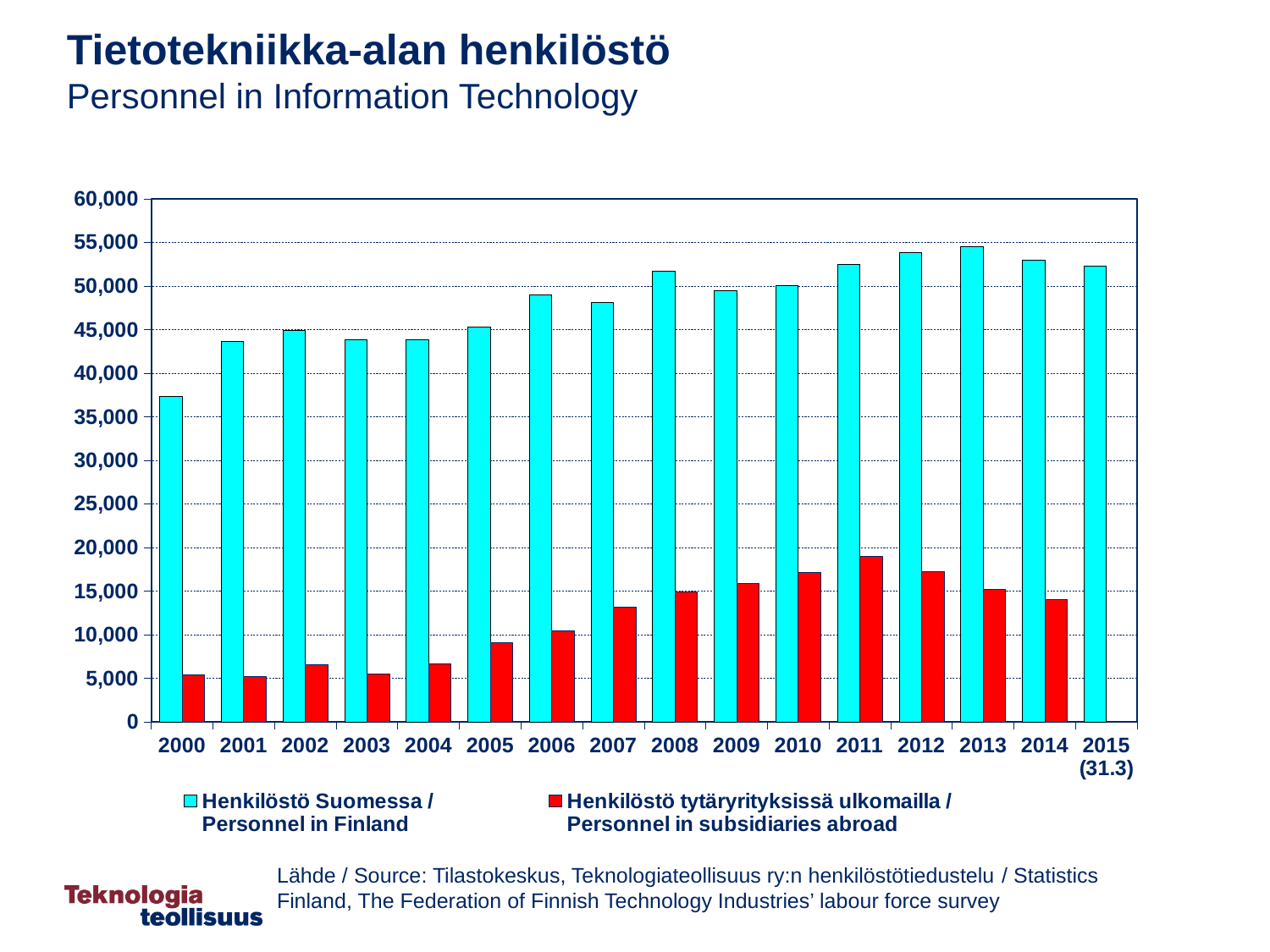
Does the value for Personnel in subsidiaries abroad generally rise or fall from 2000 to 2011? rise Is the value for Personnel in subsidiaries abroad in 2011 greater or less than 20,000? less Is the value for Personnel in Finland in 2000 greater or less than 35,000? greater Which is larger, Personnel in Finland in 2000 or in 2001? 2001 How many years are shown on the x axis? 16 Is the value for Personnel in Finland in 2008 greater or less than 50,000? greater Which is larger, Personnel in subsidiaries abroad in 2011 or in 2014? 2011 Which year has the lowest value for Personnel in Finland? 2000 Which year has the highest value for Personnel in subsidiaries abroad? 2011 How many series does the legend list? 2 What kind of chart is shown on the slide? bar chart